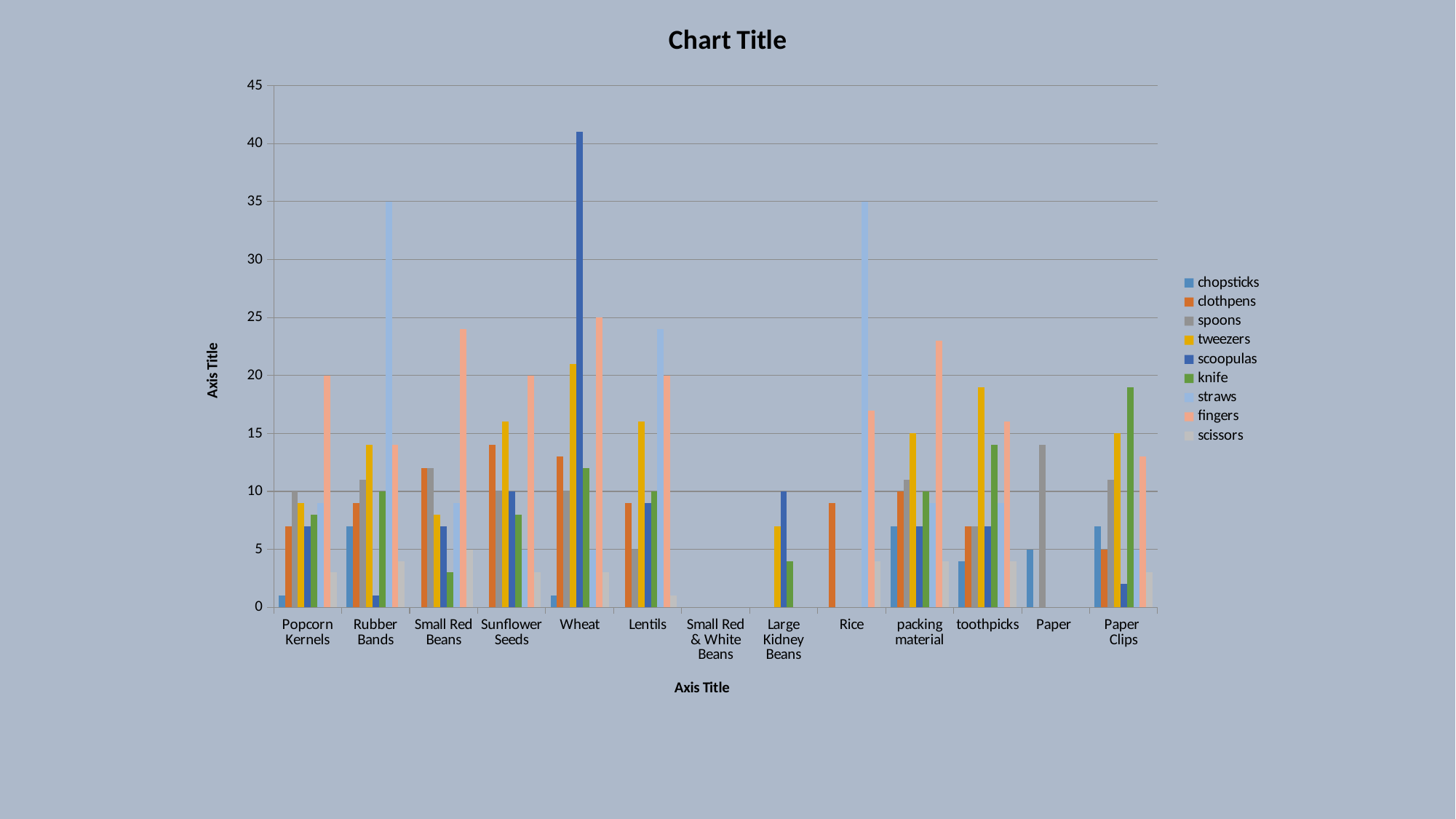
Is the value for straws at Rubber Bands greater or less than 30? greater What is the value for fingers at Wheat? 25 What kind of chart is shown on the slide? bar chart Which category contains the tallest bar in the chart? Wheat What is the title of the chart? Chart Title How many categories are shown along the x axis? 13 Is the value for clothpens at Rice greater or less than 10? less Which is larger: the value for tweezers at toothpicks or the value for tweezers at Lentils? toothpicks Is the value for fingers at Small Red Beans greater or less than 20? greater Which series has the tallest bar for Wheat? scoopulas How many series does the legend list? 9